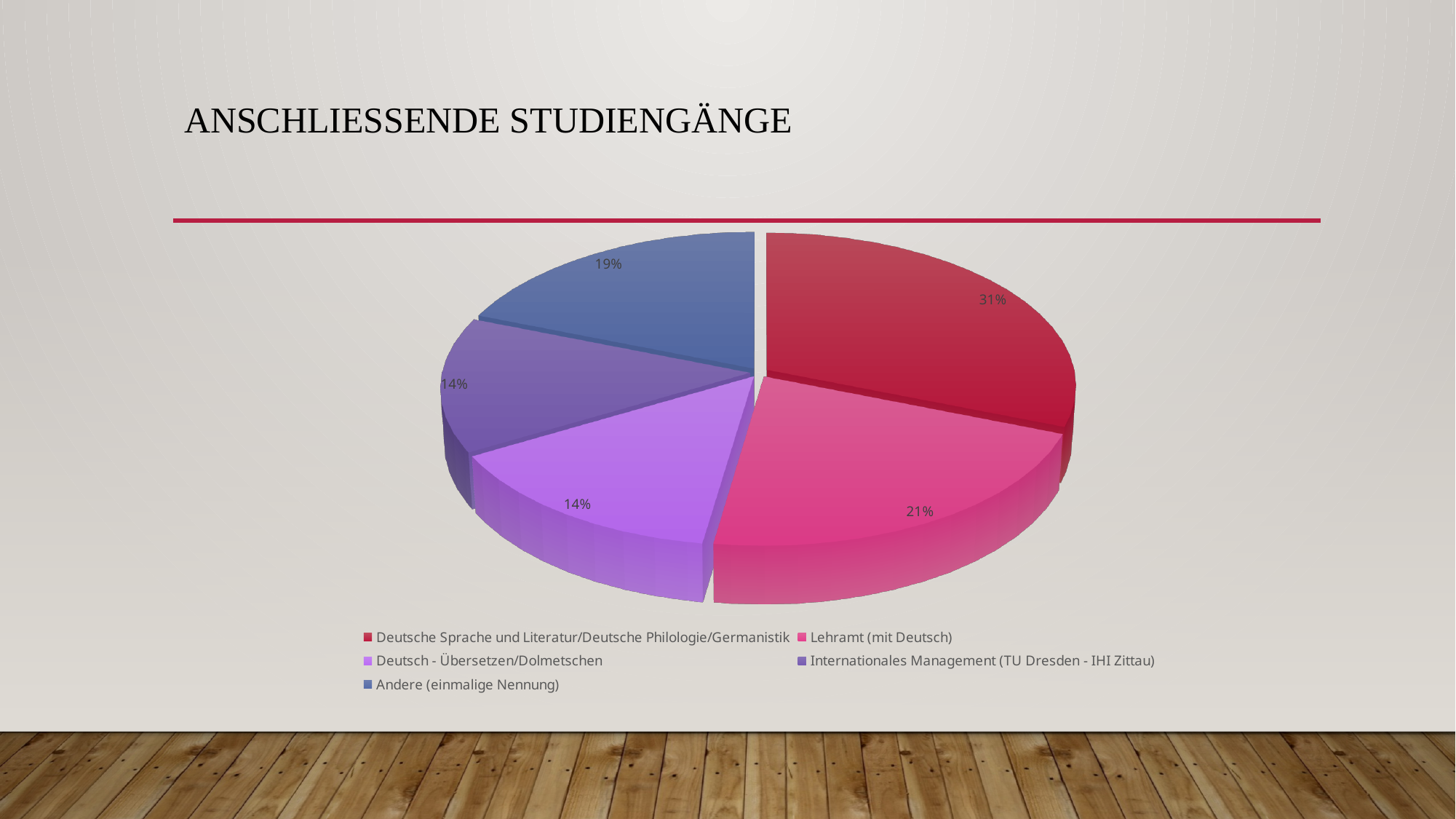
What share of the pie does "Deutsch - Übersetzen/Dolmetschen" have? 14% What kind of chart is shown on the slide? pie chart What share of the pie does "Deutsche Sprache und Literatur/Deutsche Philologie/Germanistik" have? 31% What share of the pie does "Internationales Management (TU Dresden - IHI Zittau)" have? 14% What is the difference in percentage points between the "Deutsche Sprache und Literatur/Deutsche Philologie/Germanistik" slice and the "Lehramt (mit Deutsch)" slice? 10 How many entries does the legend of the pie chart list? 5 Which slice is larger, "Andere (einmalige Nennung)" or "Deutsch - Übersetzen/Dolmetschen"? Andere (einmalige Nennung) What is the title of the slide containing the pie chart? Anschliessende Studiengänge Which category has the largest slice of the pie? Deutsche Sprache und Literatur/Deutsche Philologie/Germanistik How many slices does the pie chart have? 5